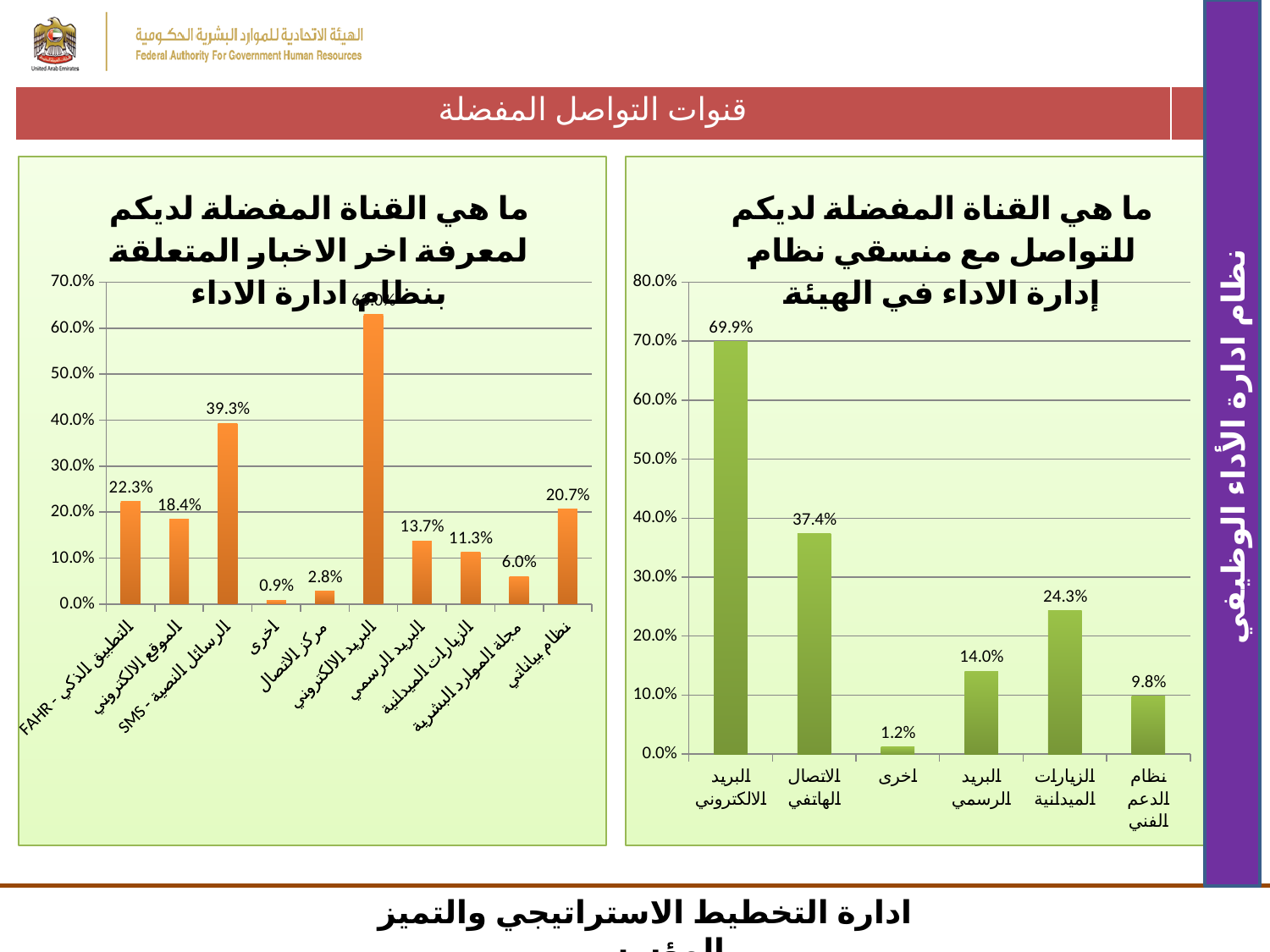
In the left chart, what is the value for نظام بياناتي? 20.7% In the right chart (preferred channel for communicating with performance management system coordinators), what is the value for البريد الالكتروني? 69.9% In the left chart, what is the difference between التطبيق الذكي - FAHR and الموقع الالكتروني? 3.9% In the right chart, how many categories are shown? 6 In the left chart, which category has the highest value? البريد الالكتروني What type of chart is the right chart? bar chart In the right chart, which is larger: نظام الدعم الفني or البريد الرسمي? البريد الرسمي In the right chart, what is the value for الزيارات الميدانية? 24.3% In the left chart (preferred channel for learning the latest news about the performance management system), what is the value for الرسائل النصية - SMS? 39.3% In the left chart, is the value for البريد الالكتروني greater or less than 60%? greater In the right chart, which category has the lowest value? اخرى In the right chart, what is the difference between الاتصال الهاتفي and البريد الرسمي? 23.4%